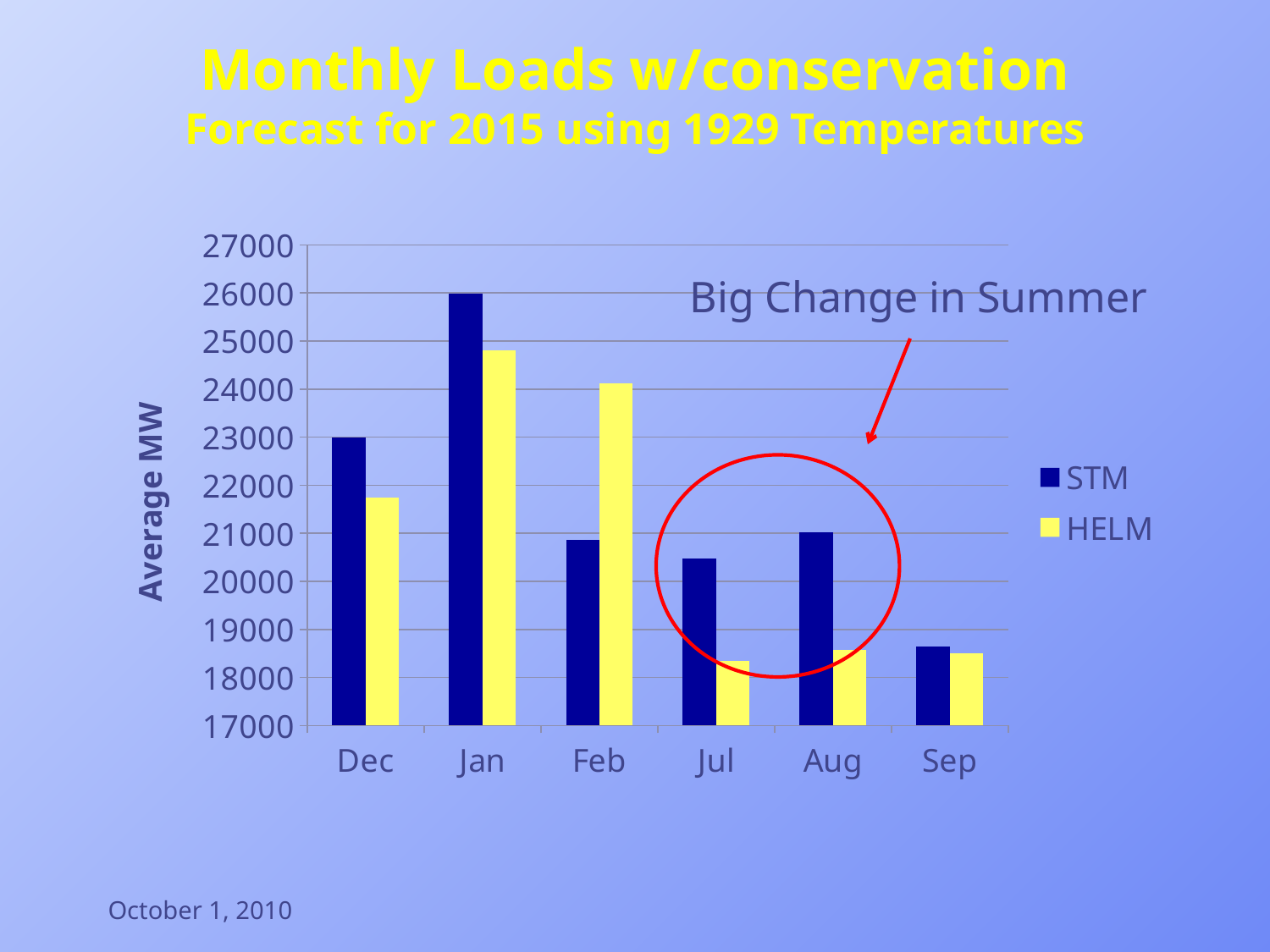
Which month has the highest STM value? Jan Is the HELM value for Jul greater or less than 19000? less How many months are shown on the x axis? 6 What kind of chart is shown on the slide? bar chart Which month has the lowest STM value? Sep In Aug, which series has the larger value, STM or HELM? STM What is the title of the y axis? Average MW How many series does the legend list? 2 In Feb, which series has the larger value, STM or HELM? HELM In Dec, which series has the larger value, STM or HELM? STM Which month has the highest HELM value? Jan Is the STM value for Jan greater or less than 25000? greater